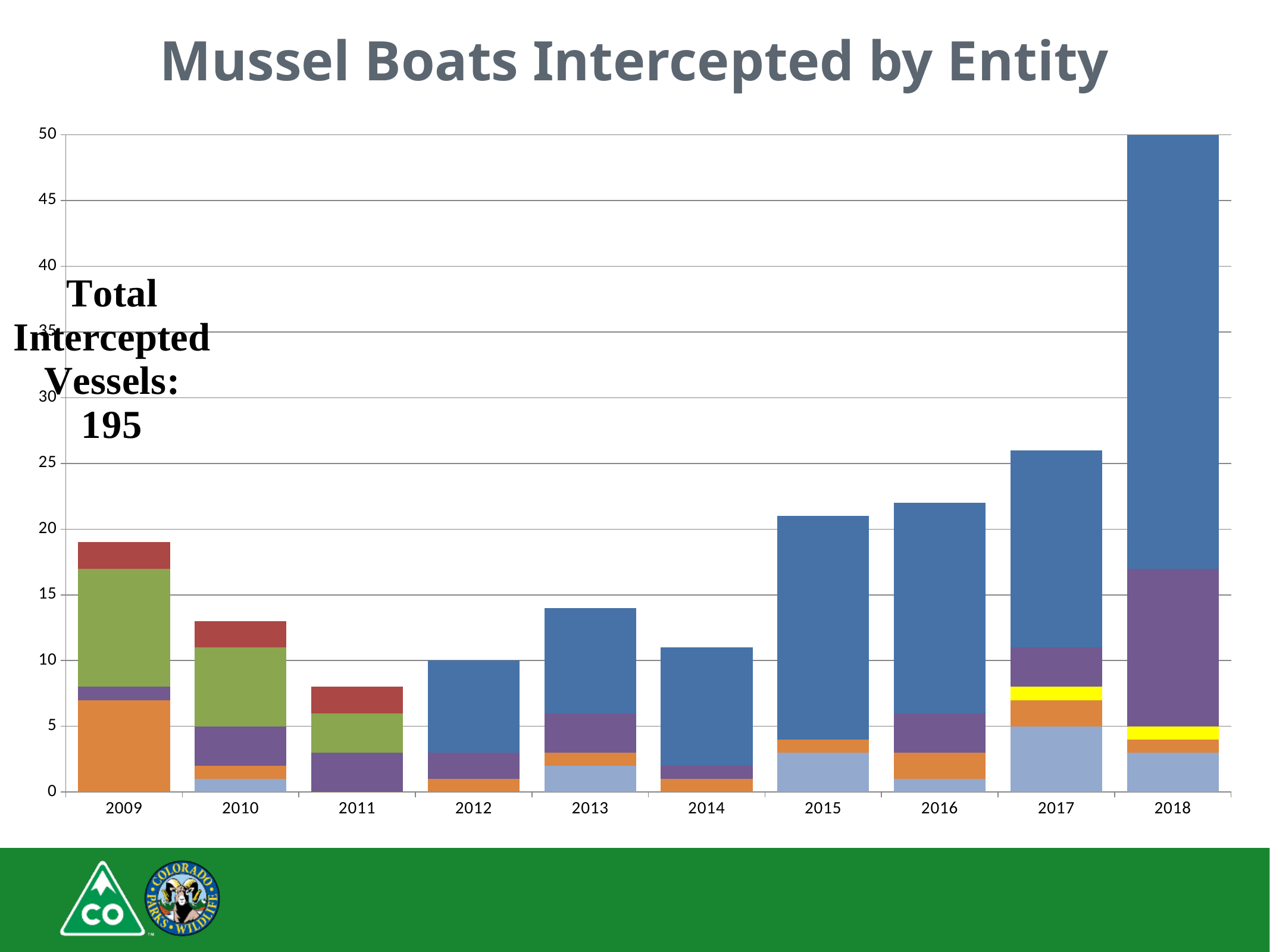
Is the total for 2014 greater or less than 15? less Which bar is taller, 2016 or 2017? 2017 Do the bar totals generally rise or fall from 2011 to 2018? Rise What is the total height of the bar for 2012? 10 How many years are shown along the x axis? 10 What kind of chart is shown on the slide? Stacked bar chart Which year has the tallest bar? 2018 Is the total for 2017 greater or less than 25? greater What is the title of the chart? Mussel Boats Intercepted by Entity Which bar is taller, 2009 or 2010? 2009 Which year has the shortest bar? 2011